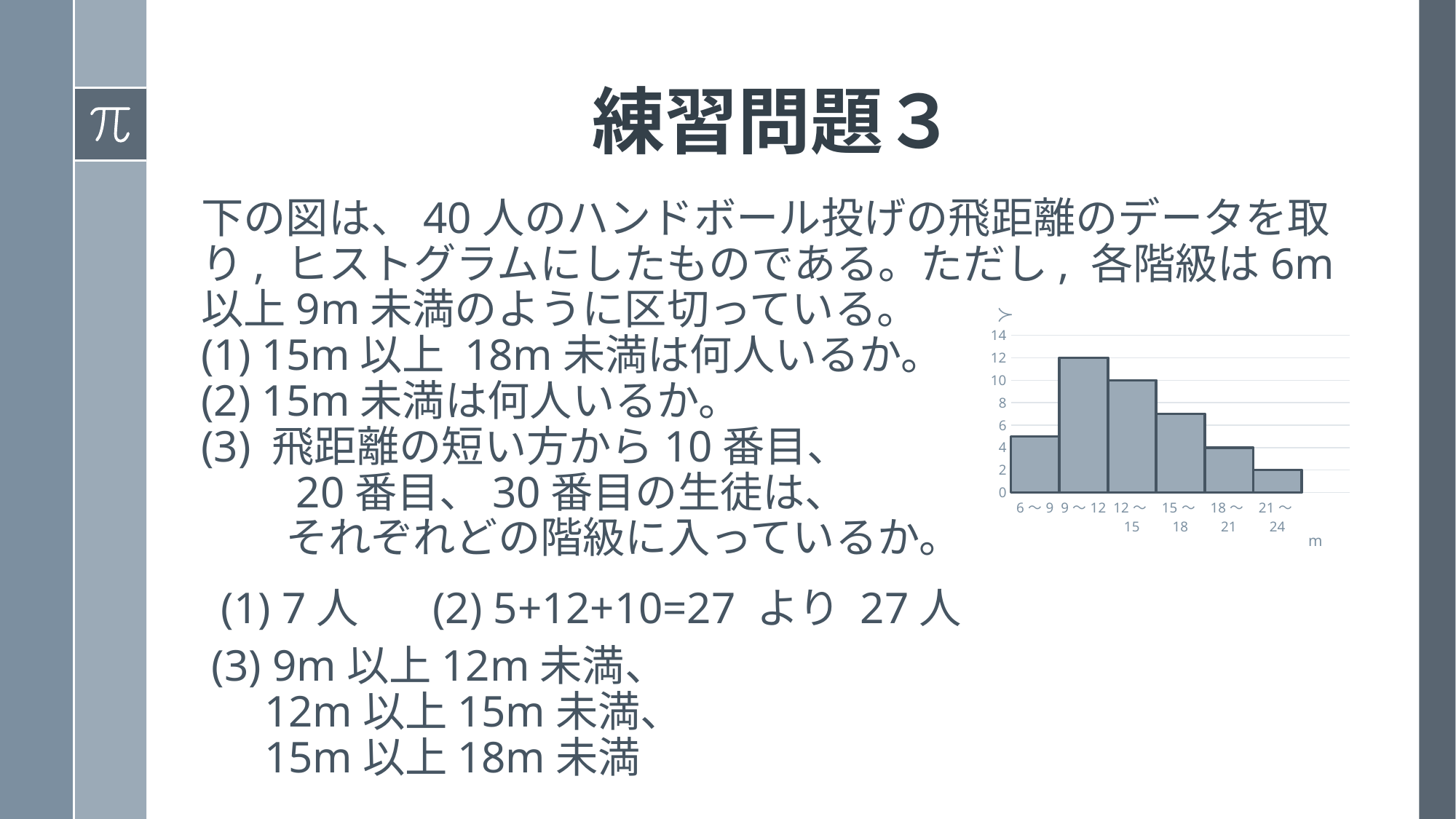
What is the difference between the values for the 9～12 class and the 12～15 class? 2 How many categories (classes) are shown on the x axis of the histogram? 6 Do the values rise or fall along the x axis from the 9～12 class to the 21～24 class? fall What is the value for the 18～21 class? 4 Which class has the highest value? 9～12 What is the value for the 21～24 class? 2 What is the value for the 9～12 class? 12 What kind of chart is shown on the slide? bar chart Is the value for the 12～15 class greater or less than 8? greater What is the value for the 15～18 class? 7 Which class has the lowest value? 21～24 Which is larger, the value for the 6～9 class or the value for the 18～21 class? 6～9